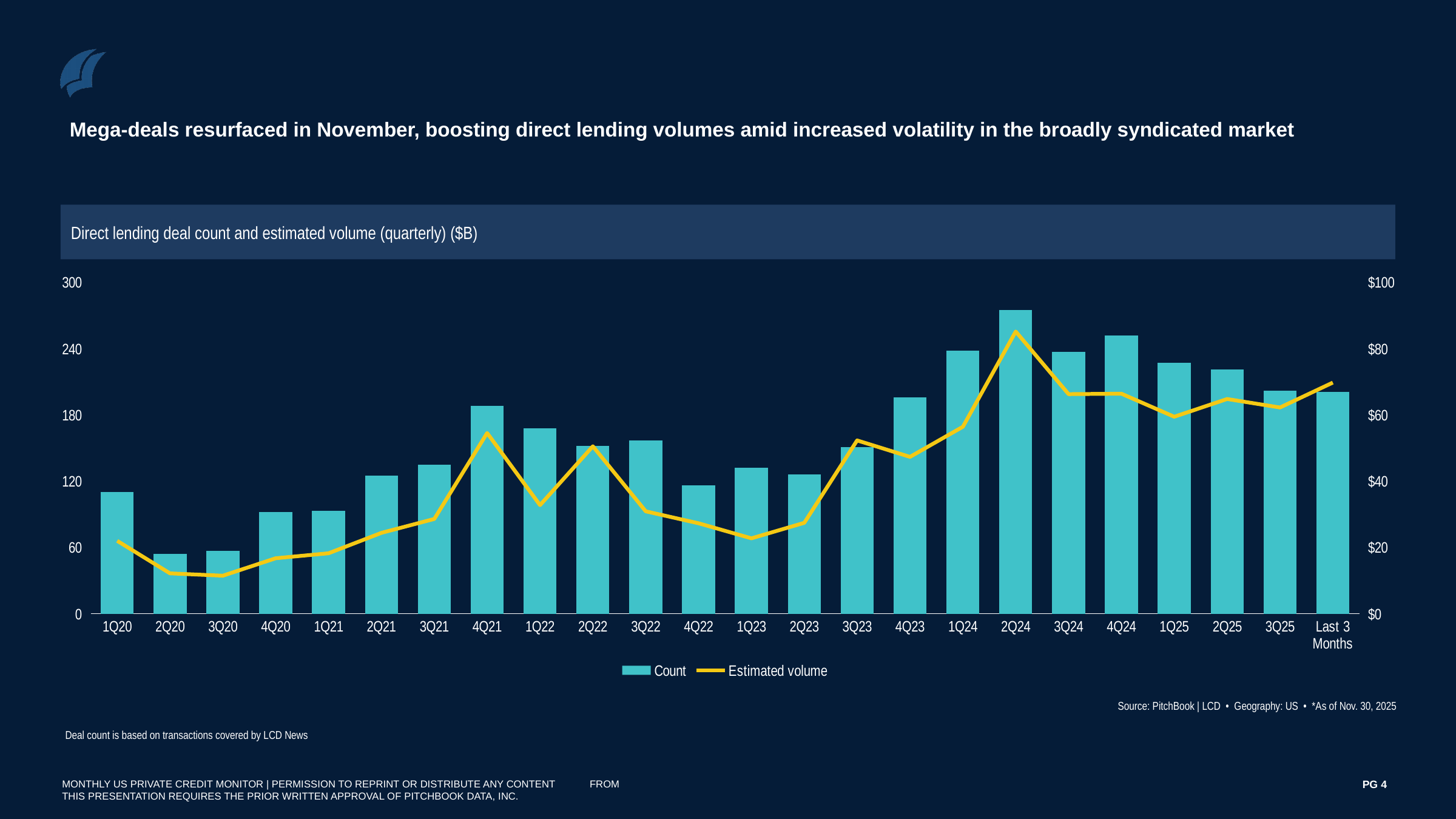
Is the deal count for 2Q24 greater or less than 240? greater Do deal counts rise or fall from 1Q23 to 2Q24? rise What is the title of the chart? Direct lending deal count and estimated volume (quarterly) ($B) What kind of chart is this? A combination bar and line chart How many series does the legend list? 2 Which has the larger deal count, 4Q21 or 1Q22? 4Q21 Is the deal count for 1Q20 greater or less than 100? greater Is the estimated volume for 3Q20 greater or less than $20? less Which quarter has the highest deal count? 2Q24 How many quarterly categories are shown on the x axis? 24